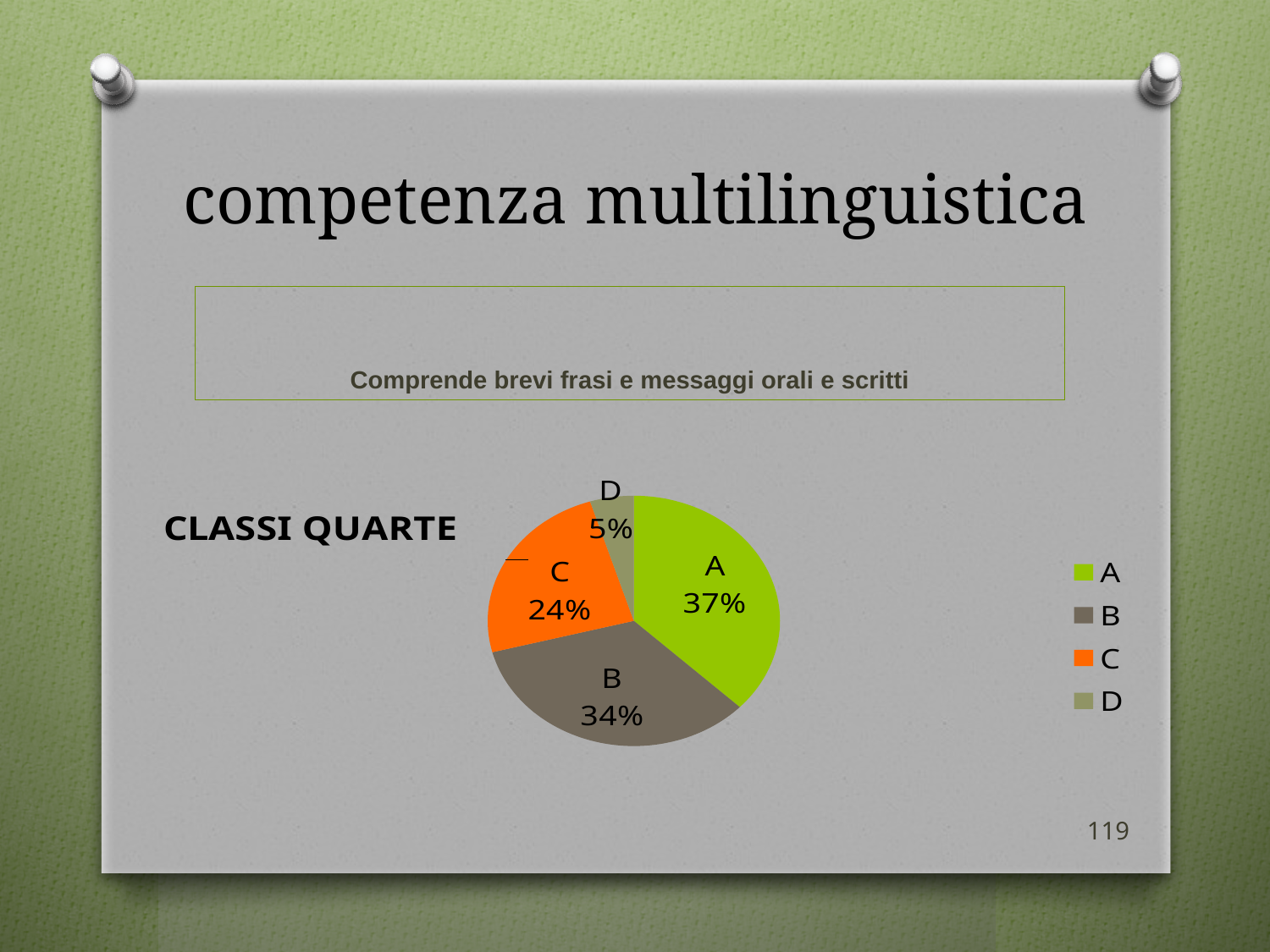
What colour is slice C in the pie chart? orange How many slices does the pie chart have? 4 What type of chart is shown on the slide? pie chart What is the difference in percentage points between slice A and slice C? 13 What percentage of the pie does slice C represent? 24% Which is larger, slice B or slice C? B What percentage of the pie does slice D represent? 5% Which slice is the smallest in the pie chart? D What percentage of the pie does slice B represent? 34% How many entries does the legend list? 4 Which slice is the largest in the pie chart? A What percentage of the pie does slice A represent? 37%